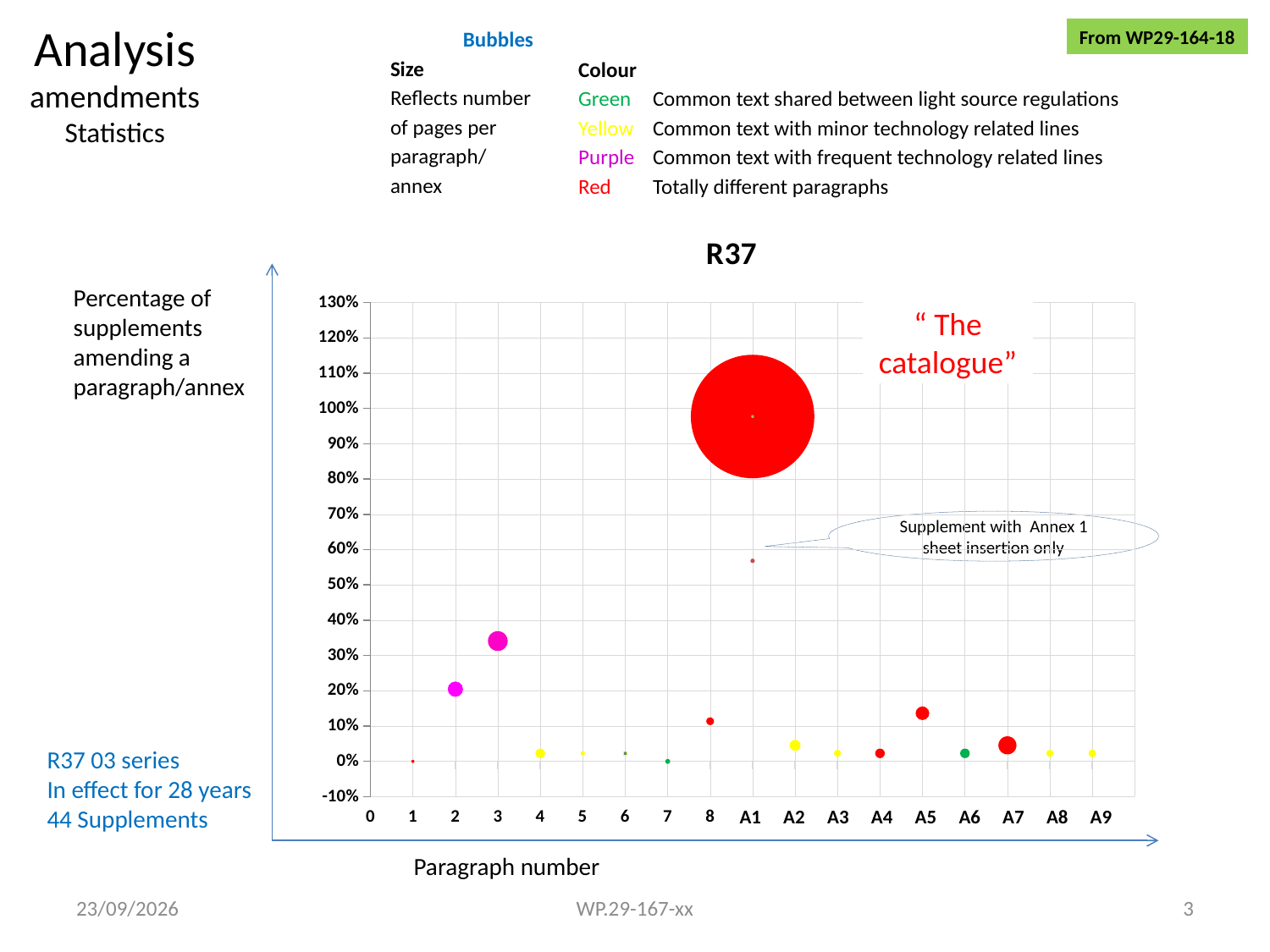
Is the value for A5 greater or less than 10%? greater Is the value for paragraph 8 greater or less than 20%? less What kind of chart is shown on the slide? Bubble chart How many paragraph/annex labels are shown on the x axis? 18 Is the value for paragraph 3 greater or less than 30%? greater Which has a higher value, paragraph 2 or paragraph 8? Paragraph 2 Which has a higher value, paragraph 2 or paragraph 3? Paragraph 3 What is the title of the chart? R37 Which paragraph/annex has the highest percentage of supplements amending it? A1 What is the x-axis title of the chart? Paragraph number